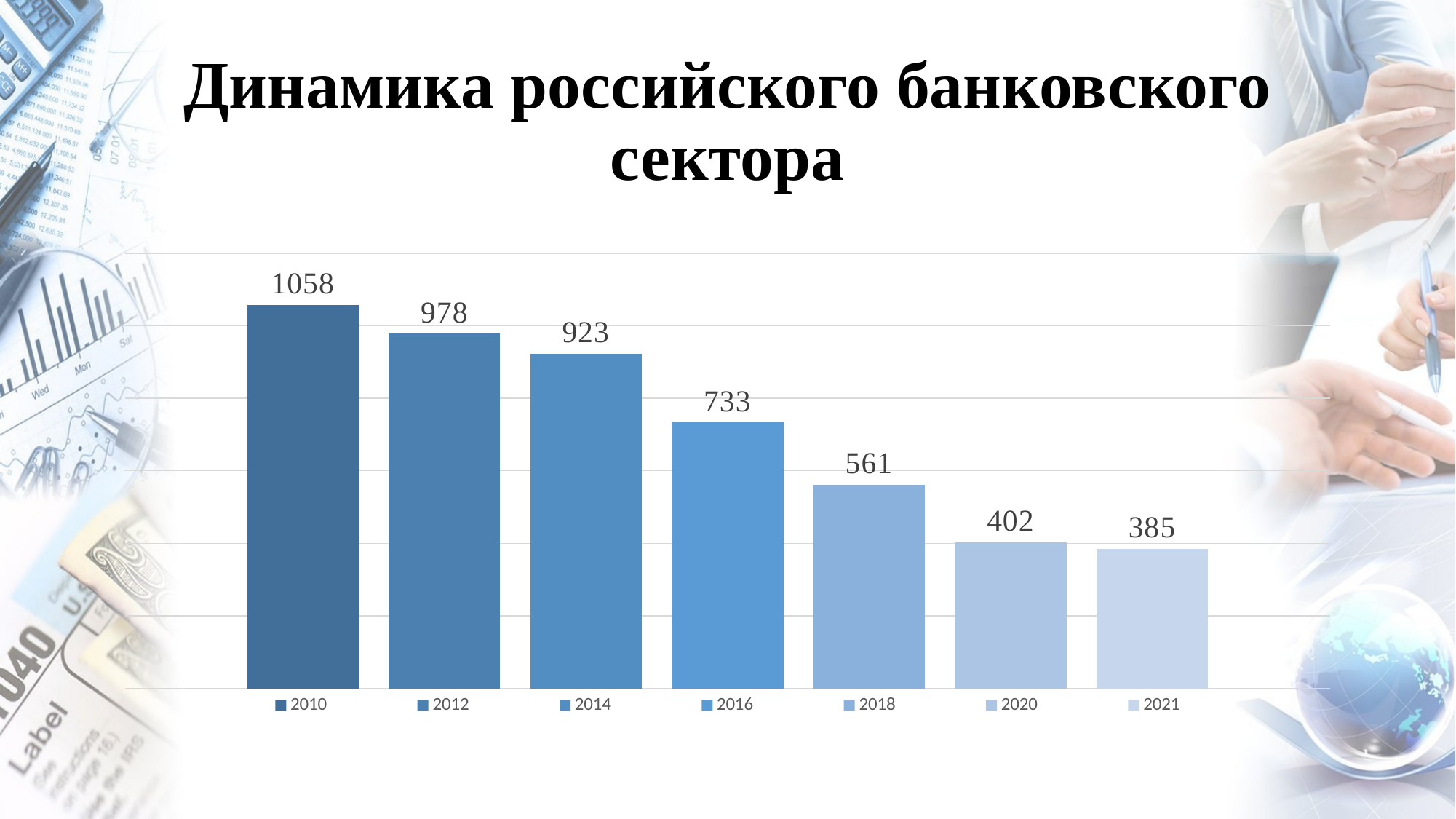
How many bars are shown in the chart? 7 What is the value for 2010? 1058 What is the difference between the values for 2010 and 2012? 80 What kind of chart is shown on the slide? Bar chart Which year has the lowest value? 2021 What is the title of the slide? Динамика российского банковского сектора What is the difference between the values for 2018 and 2020? 159 Do the values rise or fall from 2010 to 2021? Fall What is the value for 2016? 733 What is the value for 2021? 385 Which year has the highest value? 2010 Which is larger, the value for 2014 or the value for 2016? 2014